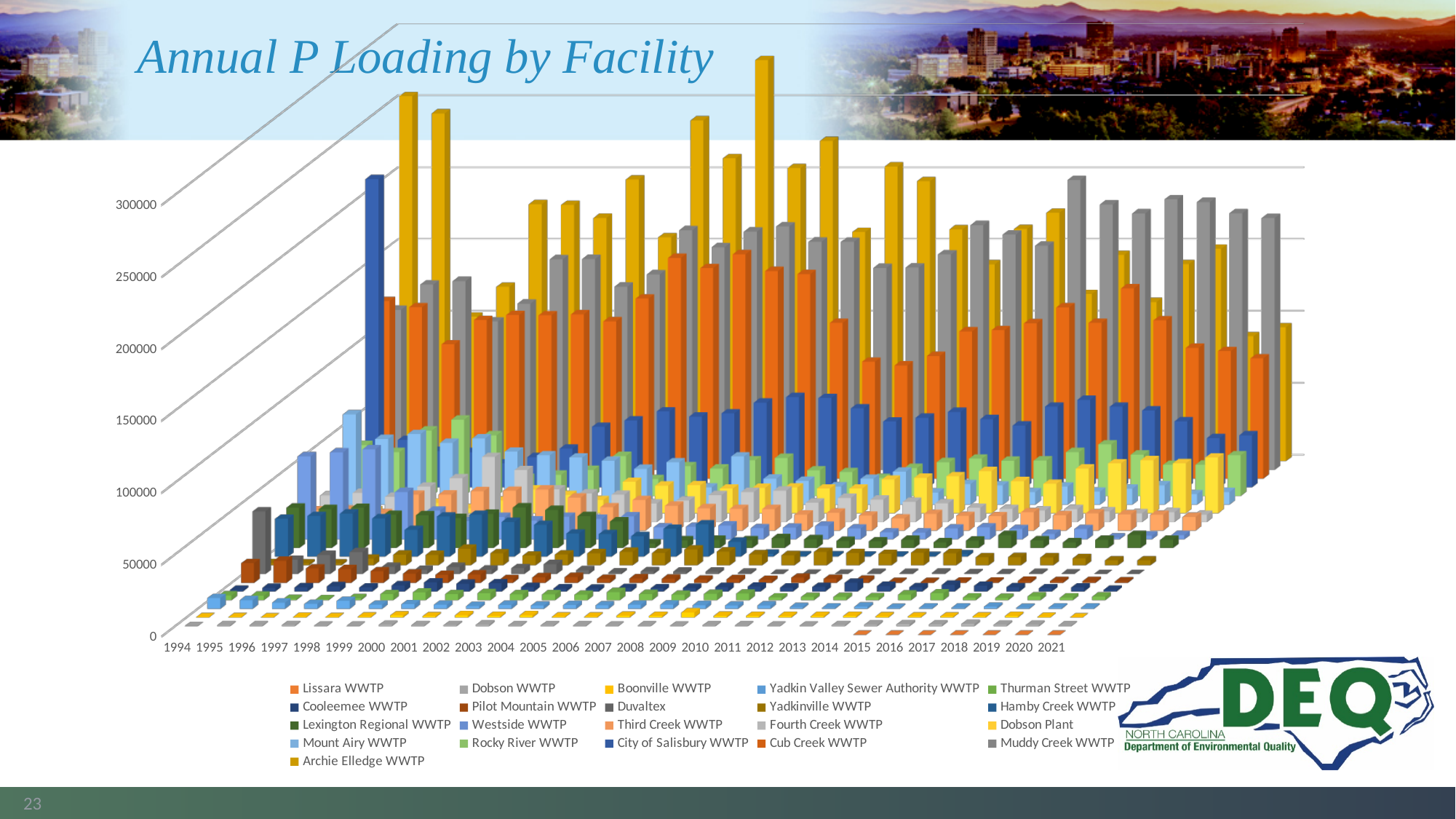
How many years are shown along the x axis of the chart? 28 What is the title of the chart? Annual P Loading by Facility How many facilities are listed in the chart's legend? 21 What is the last year shown on the x axis of the chart? 2021 Which facility has the tallest bar on the chart? Archie Elledge WWTP What kind of chart is shown on the slide? bar chart What is the first year shown on the x axis? 1994